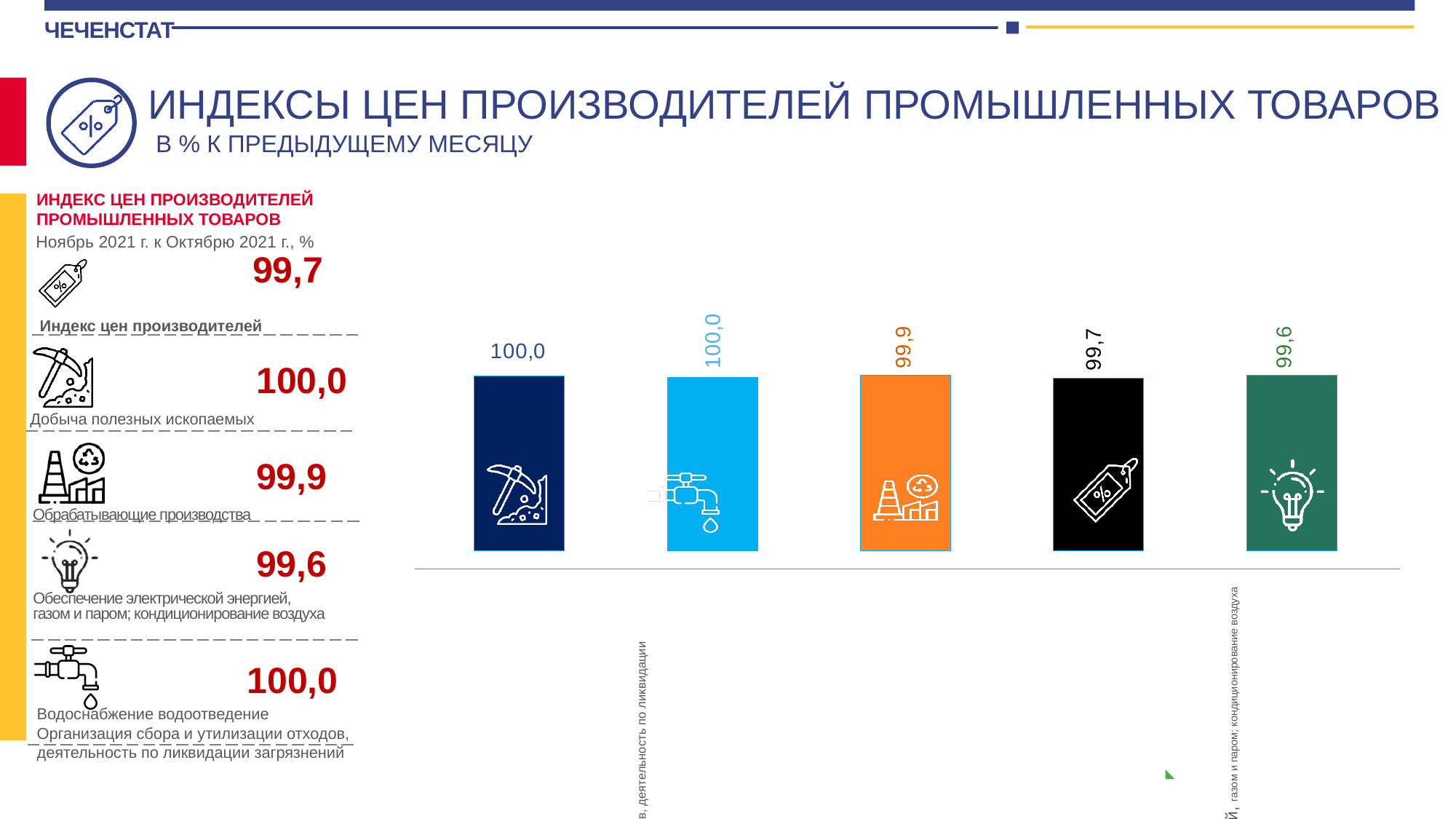
Which bar has the lowest value? the green bar (rightmost) What is the value labelled on the leftmost dark blue bar? 100,0 What is the highest value shown on the chart? 100,0 What is the value labelled on the orange bar? 99,9 How many bars does the chart contain? 5 What is the value labelled on the black bar? 99,7 What is the value labelled on the green bar at the far right? 99,6 What type of chart is shown on the slide? bar chart Which is larger, the value of the orange bar or the value of the black bar? the orange bar What is the difference between the orange bar's value and the green bar's value? 0,3 Do the bar values rise or fall from left to right across the chart? fall What is the difference between the black bar's value and the green bar's value? 0,1